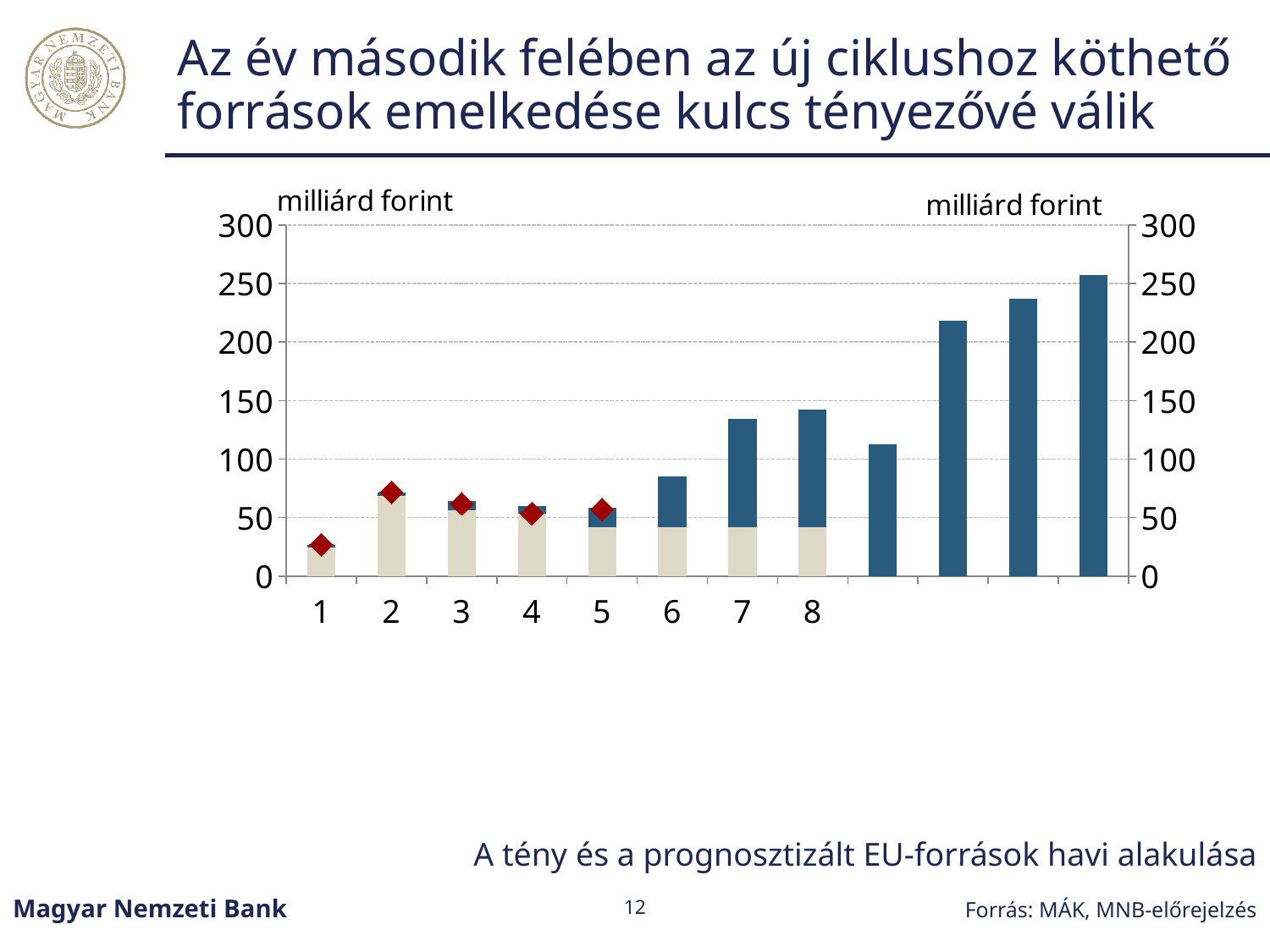
Is the value for category 7 greater or less than 100? greater What kind of chart is shown on the slide? combination bar and line chart (stacked bars with diamond markers) What is the caption given below the chart? A tény és a prognosztizált EU-források havi alakulása Among the labelled categories 1 to 8, which has the lowest value? 1 Is the value for category 6 greater or less than 100? less Which is larger, the value for category 1 or the value for category 2? category 2 Which is larger, the value for category 7 or the value for category 6? category 7 Is the value for category 2 greater or less than 50? greater What unit is shown on the vertical axis of the chart? milliárd forint Do the values rise or fall from category 5 to category 8? rise